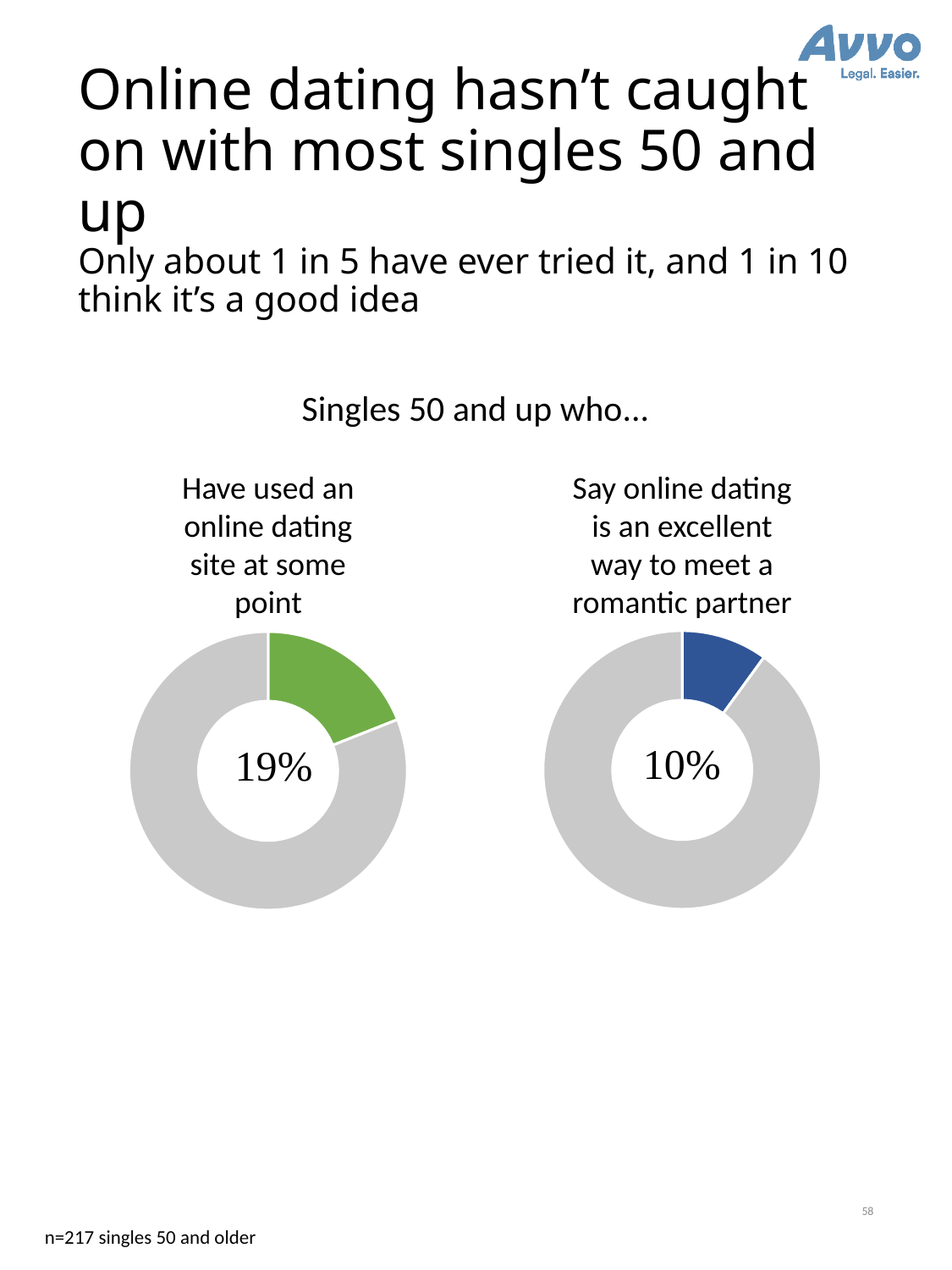
What is the sample size noted at the bottom of the slide? n=217 singles 50 and older In the right chart, what share of the doughnut is not highlighted (grey)? 90% In the right chart, what percentage of singles 50 and up say online dating is an excellent way to meet a romantic partner? 10% In the left chart, what colour is the highlighted slice representing 19%? Green In the right chart, what colour is the highlighted slice representing 10%? Blue Which is larger: the share who have used an online dating site or the share who say online dating is an excellent way to meet a romantic partner? Have used an online dating site at some point What kind of chart is used on this slide to show the percentages? Doughnut (pie) chart What is the difference in percentage points between the left chart's value (19%) and the right chart's value (10%)? 9 percentage points In the left chart, what share of the doughnut is not highlighted (grey)? 81% How many doughnut charts are shown on the slide? 2 In the left chart, what percentage of singles 50 and up have used an online dating site at some point? 19%